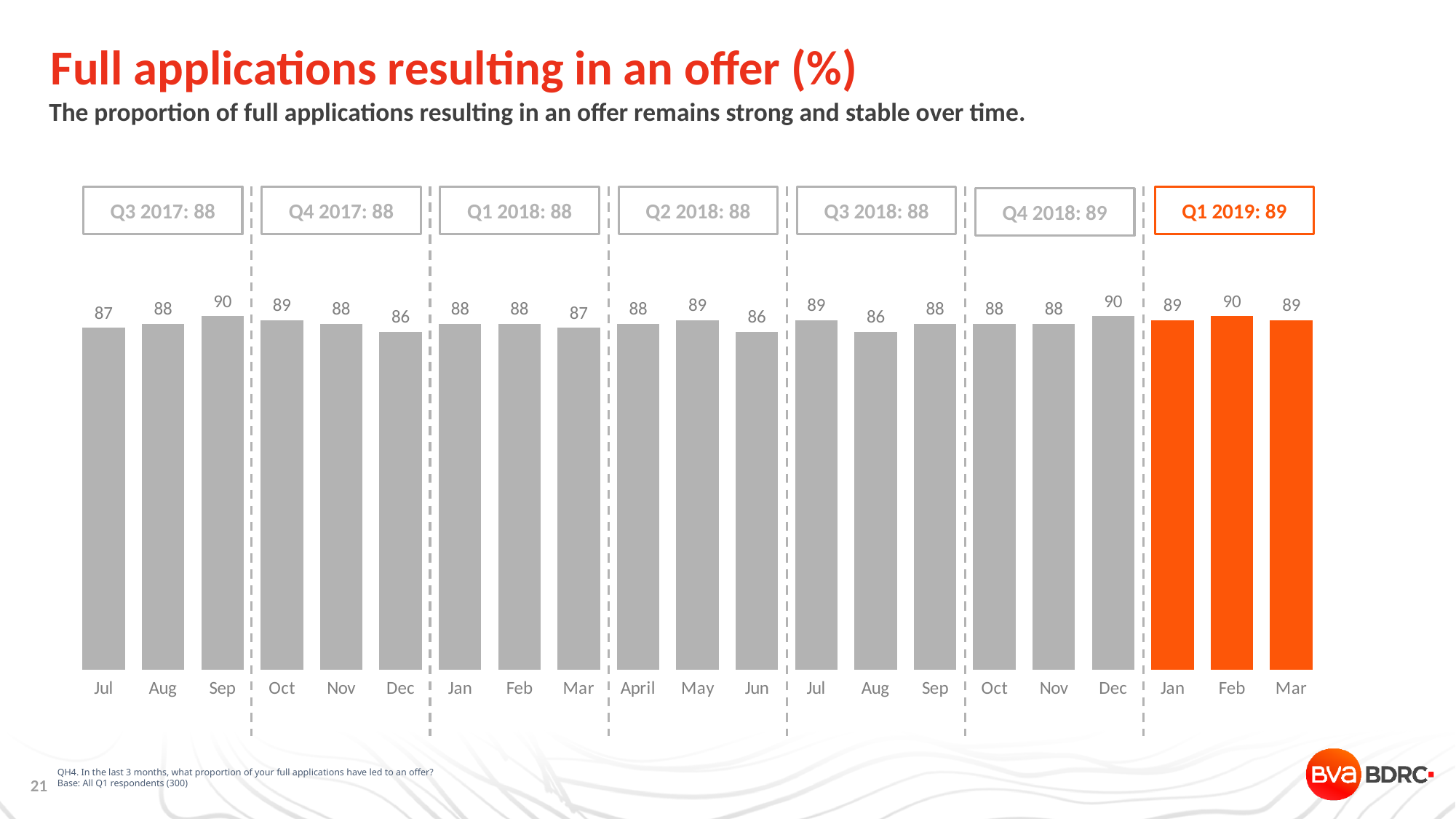
What is the value for Mar in the Q1 2019 section of the chart? 89 In the Q4 2018 section, which is larger, the value for Nov or the value for Dec? Dec How many monthly bars are plotted in the chart? 21 Within the Q3 2017 section, which month has the highest value? Sep What is the quarterly figure shown in the box for Q4 2018? 89 What is the difference between the Q1 2019 quarterly figure and the Q1 2018 quarterly figure shown in the boxes? 1 Which quarter's bars and box are highlighted in orange rather than grey? Q1 2019 What is the value for Dec in the Q4 2017 section of the chart? 86 What is the difference between the Sep and Jul values in the Q3 2017 section? 3 What kind of chart is shown on the slide? bar chart What is the value for Feb in the Q1 2019 section of the chart? 90 Within the Q2 2018 section, which month has the lowest value? Jun